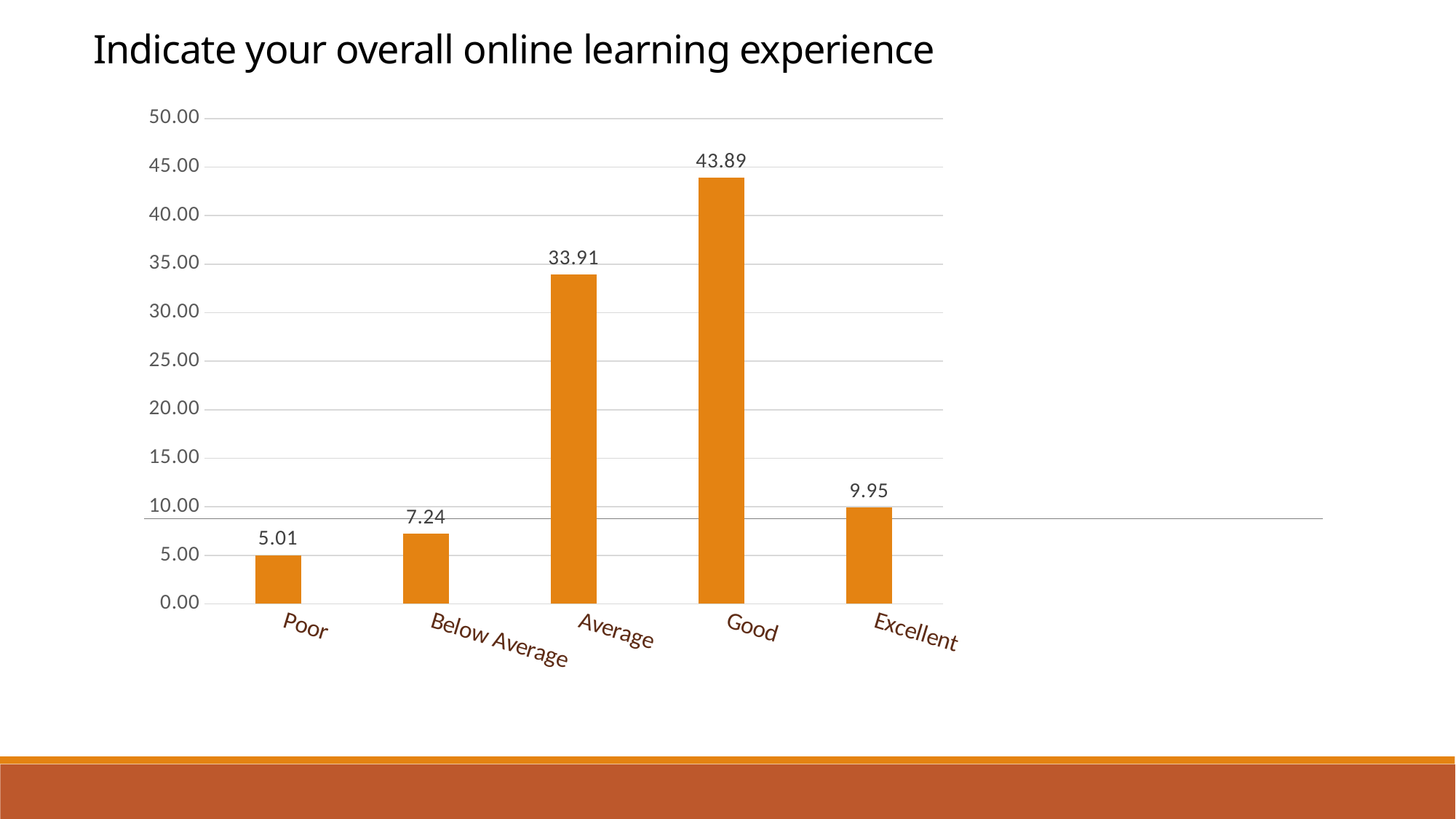
What is the title of the slide? Indicate your overall online learning experience Which category has the lowest value? Poor What is the value for Poor? 5.01 What is the value for Below Average? 7.24 What is the difference between the values for Good and Average? 9.98 What is the value for Excellent? 9.95 Which is larger, the value for Excellent or the value for Below Average? Excellent Which category has the highest value? Good How many categories are shown on the x axis? 5 What is the value for Good? 43.89 Is the value for Average greater or less than 30.00? greater What kind of chart is shown on the slide? bar chart